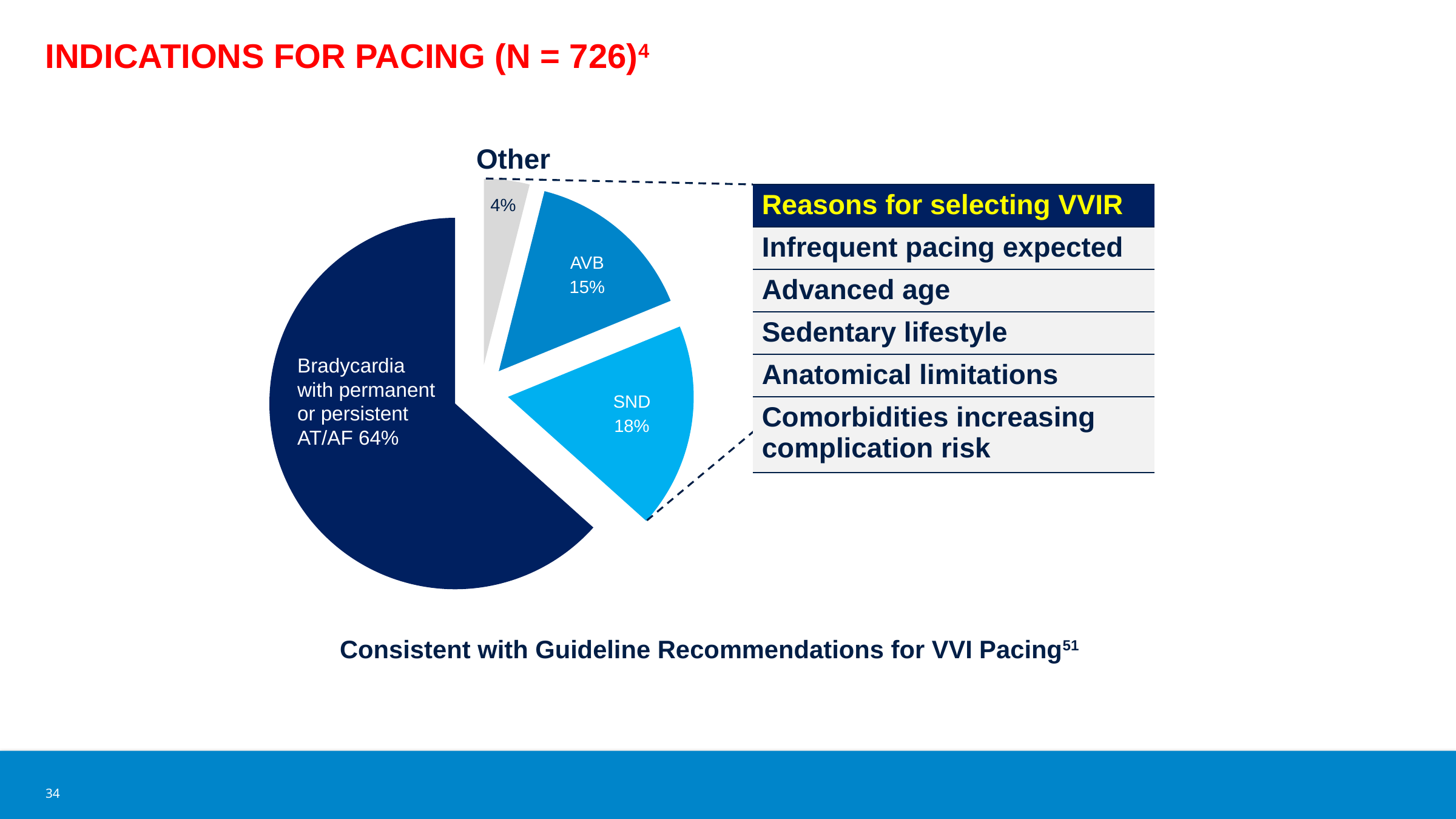
What percentage of the pie is SND? 18% What percentage of the pie is AVB? 15% How many slices does the pie chart have? 4 What percentage of the pie is Bradycardia with permanent or persistent AT/AF? 64% Which is larger, the SND slice or the AVB slice? SND What is the difference in percentage points between the SND slice and the AVB slice? 3 Which slice of the pie is the smallest? Other What kind of chart is shown on the slide? Pie chart What is the difference in percentage points between the Bradycardia with permanent or persistent AT/AF slice and the SND slice? 46 What is the title of the slide containing the pie chart? INDICATIONS FOR PACING (N = 726) What percentage of the pie is the Other slice? 4% Which slice of the pie is the largest? Bradycardia with permanent or persistent AT/AF